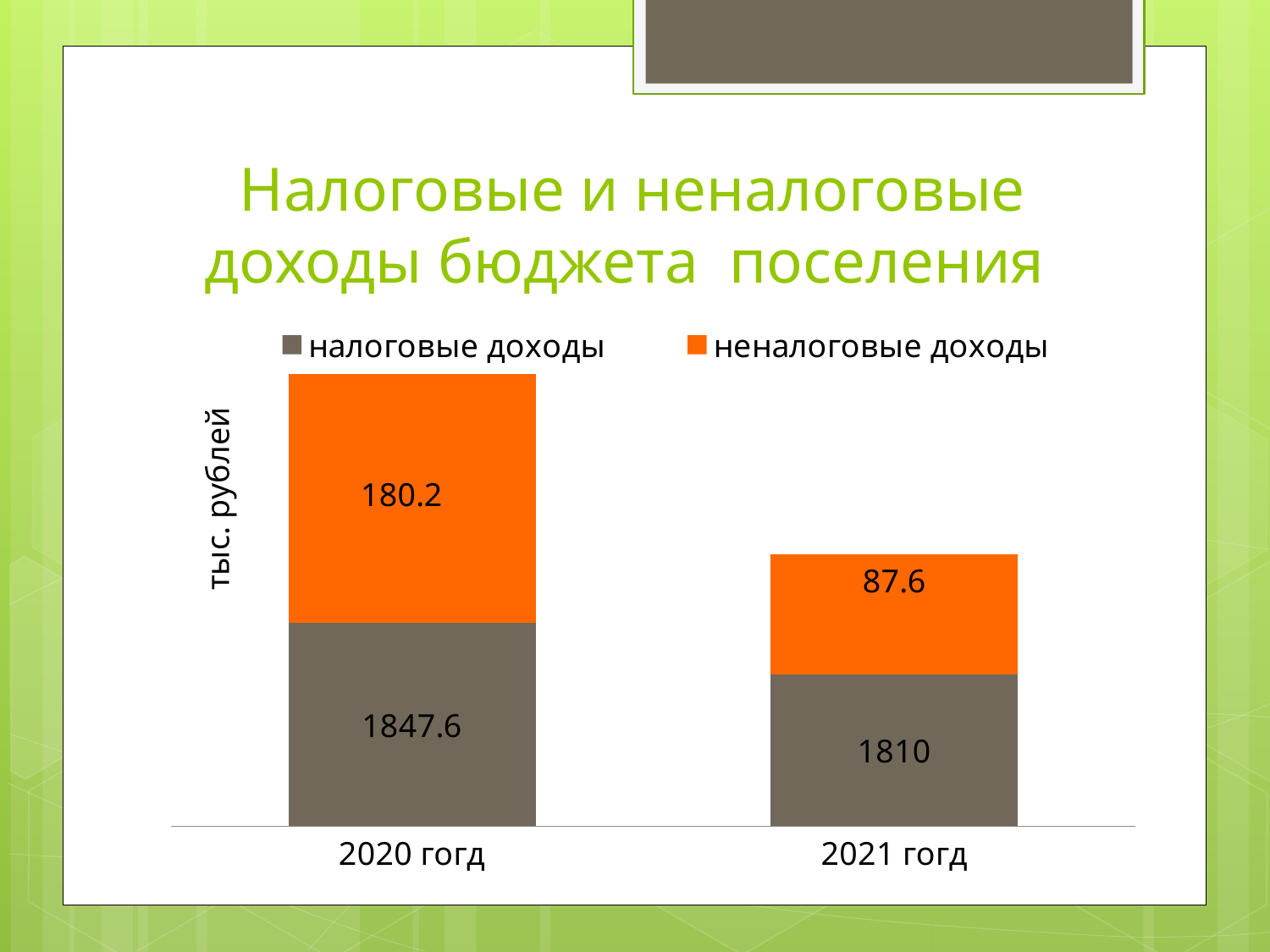
How many series does the legend list? 2 What is the value of налоговые доходы for 2020 гогд? 1847.6 What is the difference between неналоговые доходы in 2020 гогд and 2021 гогд? 92.6 What is the value of неналоговые доходы for 2021 гогд? 87.6 What is the title of the chart? Налоговые и неналоговые доходы бюджета поселения What is the value of неналоговые доходы for 2020 гогд? 180.2 What kind of chart is shown on the slide? Stacked bar chart Which year has the higher value of неналоговые доходы? 2020 гогд What is the difference between налоговые доходы in 2020 гогд and 2021 гогд? 37.6 What is the total of the stacked bar for 2021 гогд? 1897.6 What is the value of налоговые доходы for 2021 гогд? 1810 What is the total of the stacked bar for 2020 гогд? 2027.8